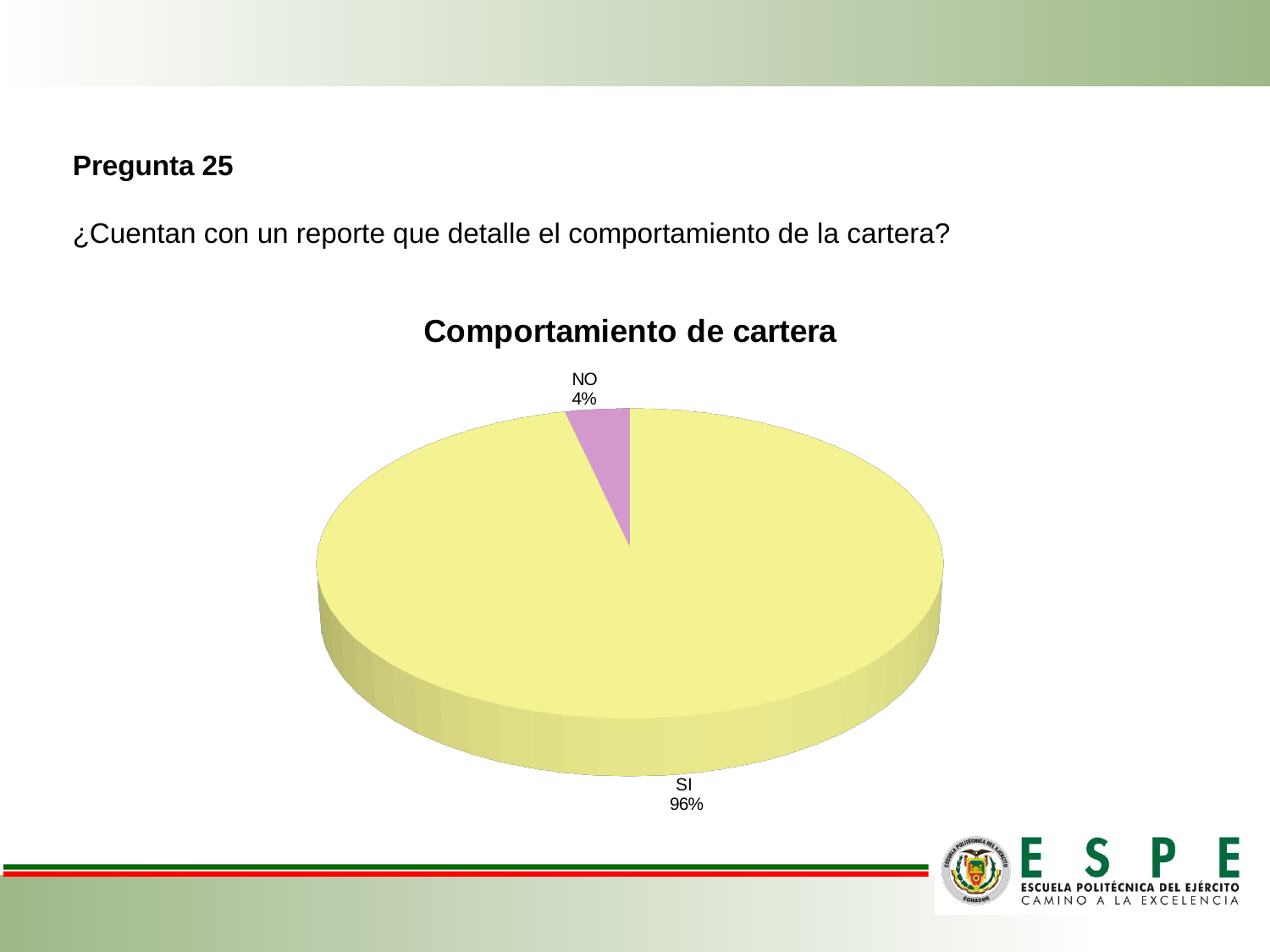
What share of the pie does the NO slice represent? 4% What is the title of the chart? Comportamiento de cartera What is the difference in percentage points between the SI and NO slices? 92 What kind of chart is shown on the slide? Pie chart Which category has the largest share of the pie chart? SI Which category has the smallest share of the pie chart? NO How many slices does the pie chart have? 2 What percentage of the pie chart corresponds to NO? 4% What colour is the SI slice of the pie chart? Yellow Which slice is larger, SI or NO? SI What percentage of the pie chart corresponds to SI? 96%